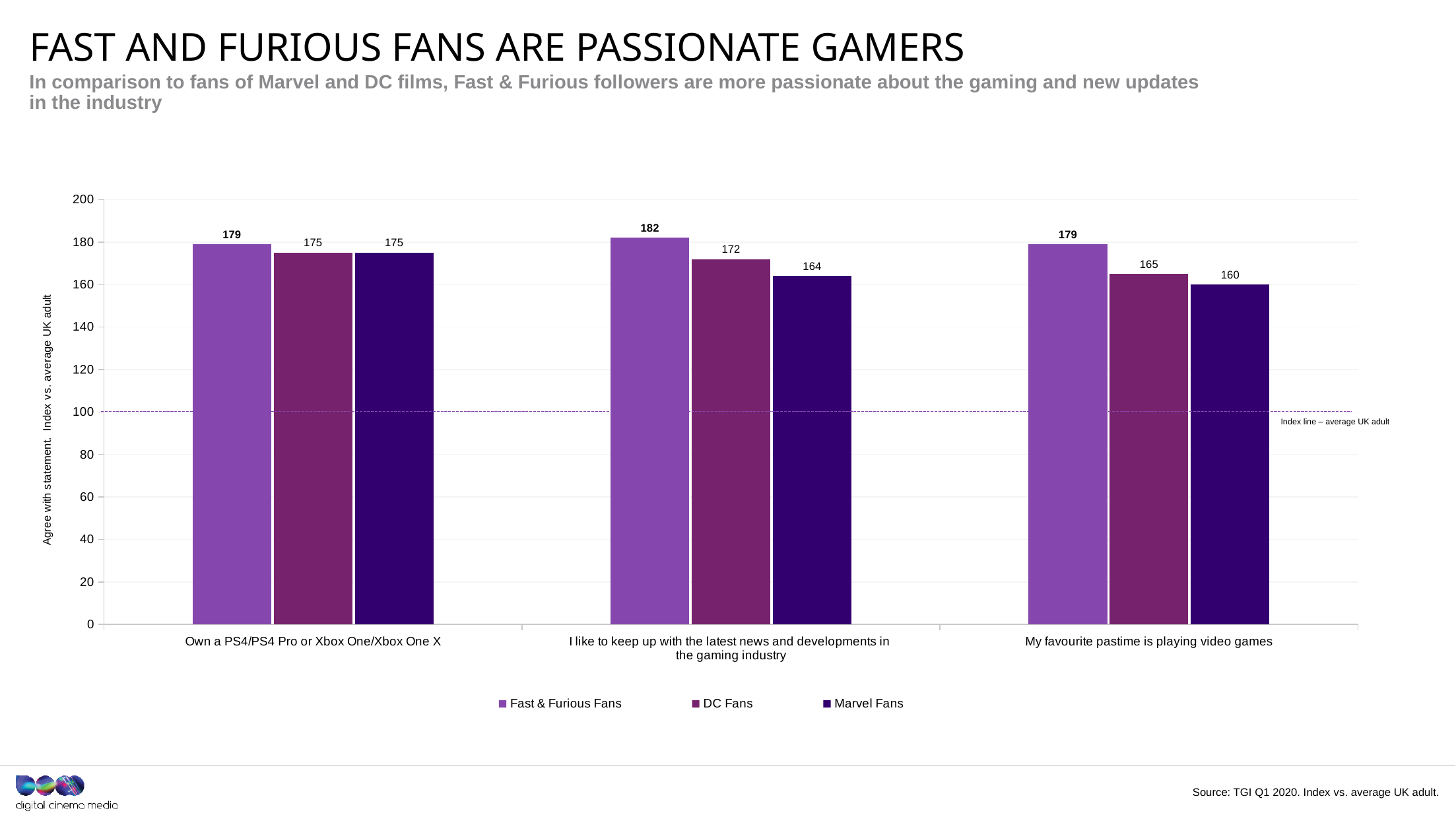
What is the value for Fast & Furious Fans for "I like to keep up with the latest news and developments in the gaming industry"? 182 Is the value for Marvel Fans for "Own a PS4/PS4 Pro or Xbox One/Xbox One X" greater or less than 160? greater Which is larger for "My favourite pastime is playing video games": the DC Fans value or the Marvel Fans value? DC Fans What is the value for Marvel Fans for "My favourite pastime is playing video games"? 160 Which series has the lowest value for "I like to keep up with the latest news and developments in the gaming industry"? Marvel Fans What is the difference between the Fast & Furious Fans and Marvel Fans values for "I like to keep up with the latest news and developments in the gaming industry"? 18 What kind of chart is shown on the slide? Bar chart What is the value for DC Fans for "Own a PS4/PS4 Pro or Xbox One/Xbox One X"? 175 Which series has the highest value for "My favourite pastime is playing video games"? Fast & Furious Fans How many statement categories are shown on the x axis? 3 How many series does the legend list? 3 At what value is the dashed index line drawn? 100